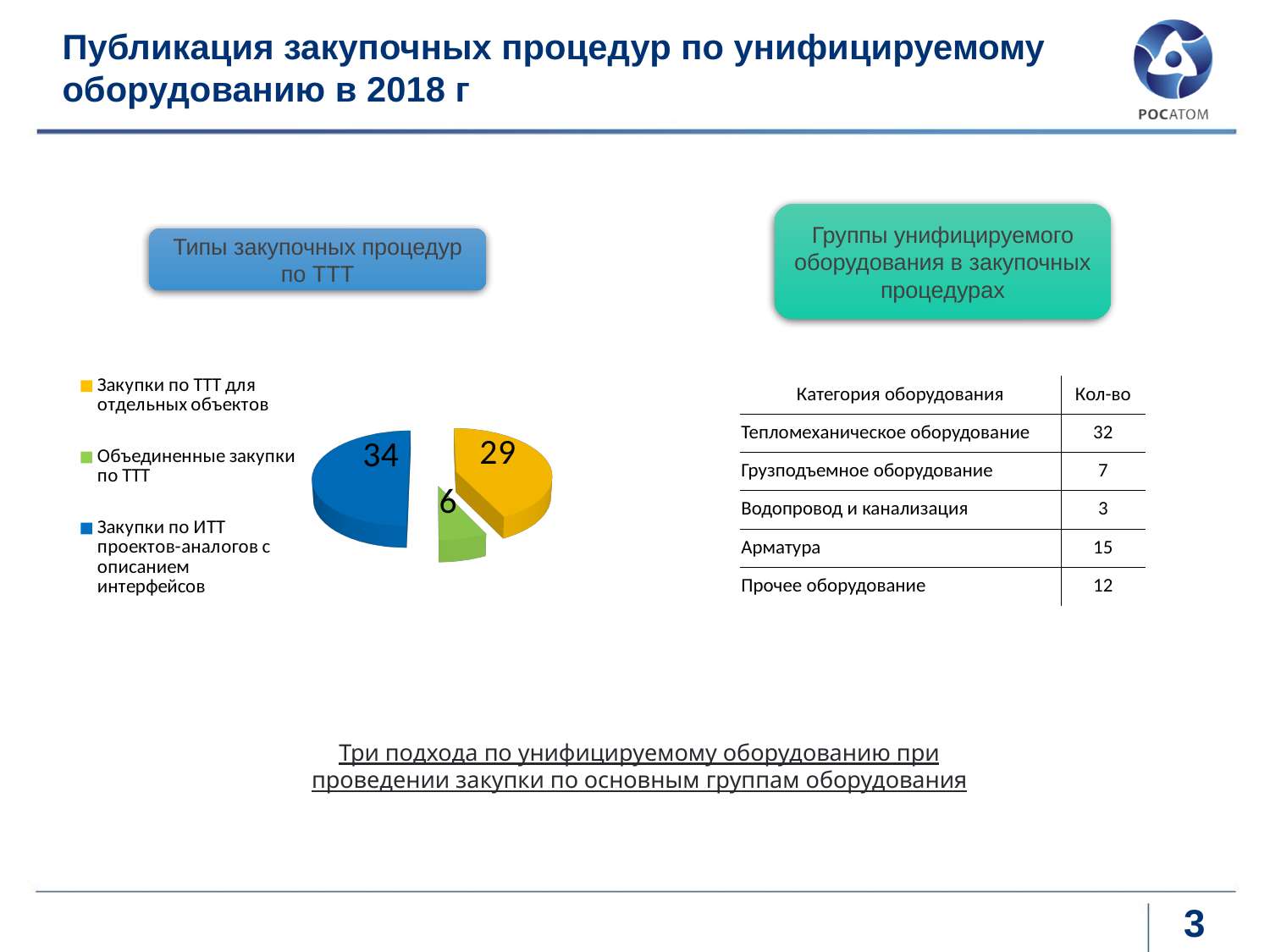
What is the value for "Объединенные закупки по ТТТ" in the pie chart? 6 How many slices does the pie chart have? 3 What type of chart is shown on the slide? Pie chart What is the difference between the values for "Закупки по ИТТ проектов-аналогов с описанием интерфейсов" and "Закупки по ТТТ для отдельных объектов"? 5 Which category has the largest slice in the pie chart? Закупки по ИТТ проектов-аналогов с описанием интерфейсов Which is larger: the value for "Закупки по ТТТ для отдельных объектов" or for "Объединенные закупки по ТТТ"? Закупки по ТТТ для отдельных объектов What is the total of all values shown in the pie chart? 69 Which category has the smallest slice in the pie chart? Объединенные закупки по ТТТ What colour is the slice for "Объединенные закупки по ТТТ" in the pie chart? Green What is the value for "Закупки по ТТТ для отдельных объектов" in the pie chart? 29 What is the difference between the values for "Закупки по ТТТ для отдельных объектов" and "Объединенные закупки по ТТТ"? 23 What is the value for "Закупки по ИТТ проектов-аналогов с описанием интерфейсов" in the pie chart? 34